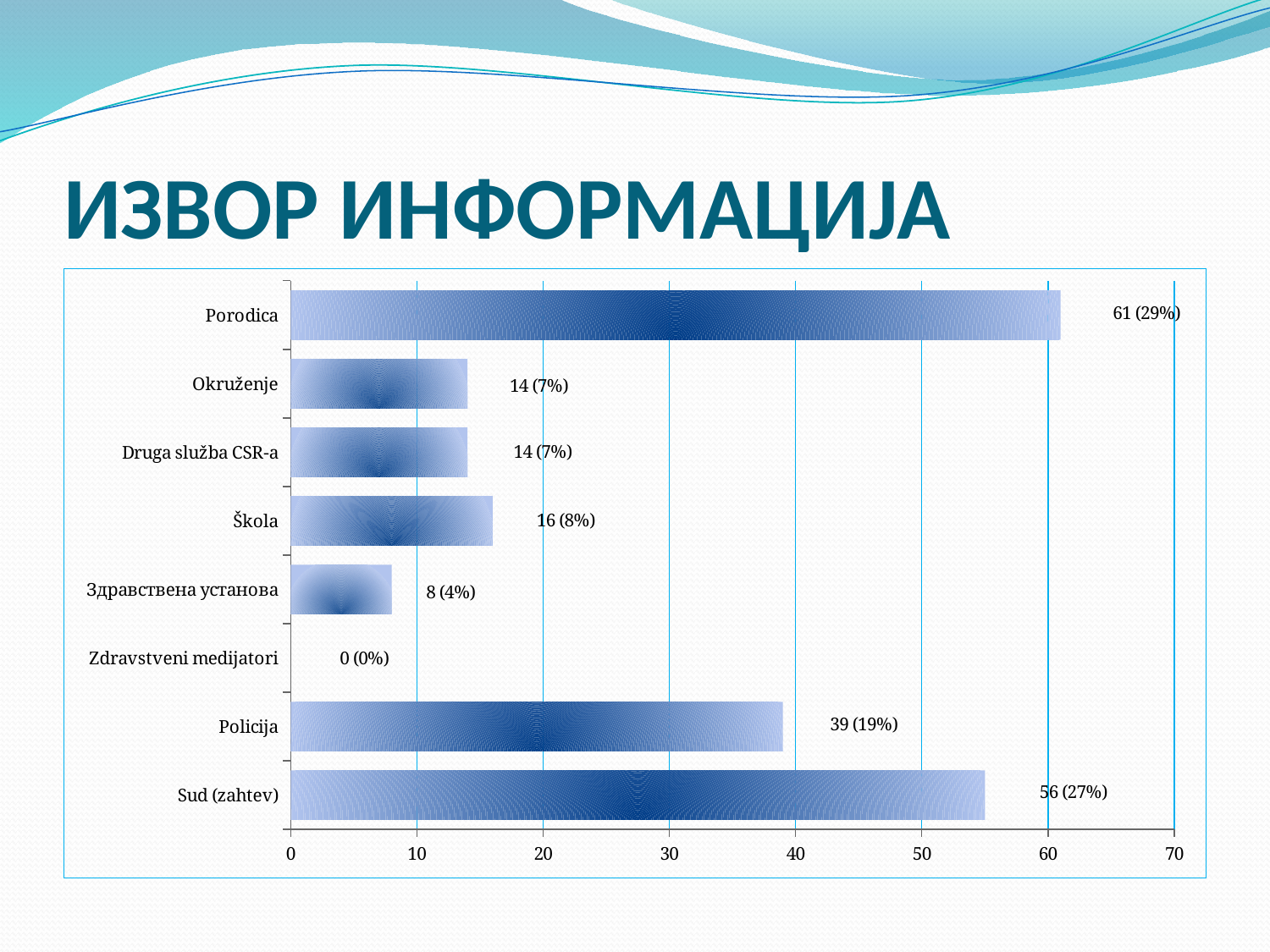
What value is shown for Policija? 39 (19%) What value is shown for Porodica? 61 (29%) How many categories are shown in the chart? 8 What is the difference between the counts for Porodica and Sud (zahtev)? 5 Is the value for Policija greater or less than 40? less What is the title of the slide? ИЗВОР ИНФОРМАЦИЈА What value is shown for Здравствена установа? 8 (4%) What kind of chart is shown on the slide? bar chart Which is larger, the value for Škola or the value for Okruženje? Škola What value is shown for Sud (zahtev)? 56 (27%) Which category has the lowest value? Zdravstveni medijatori Which category has the highest value? Porodica